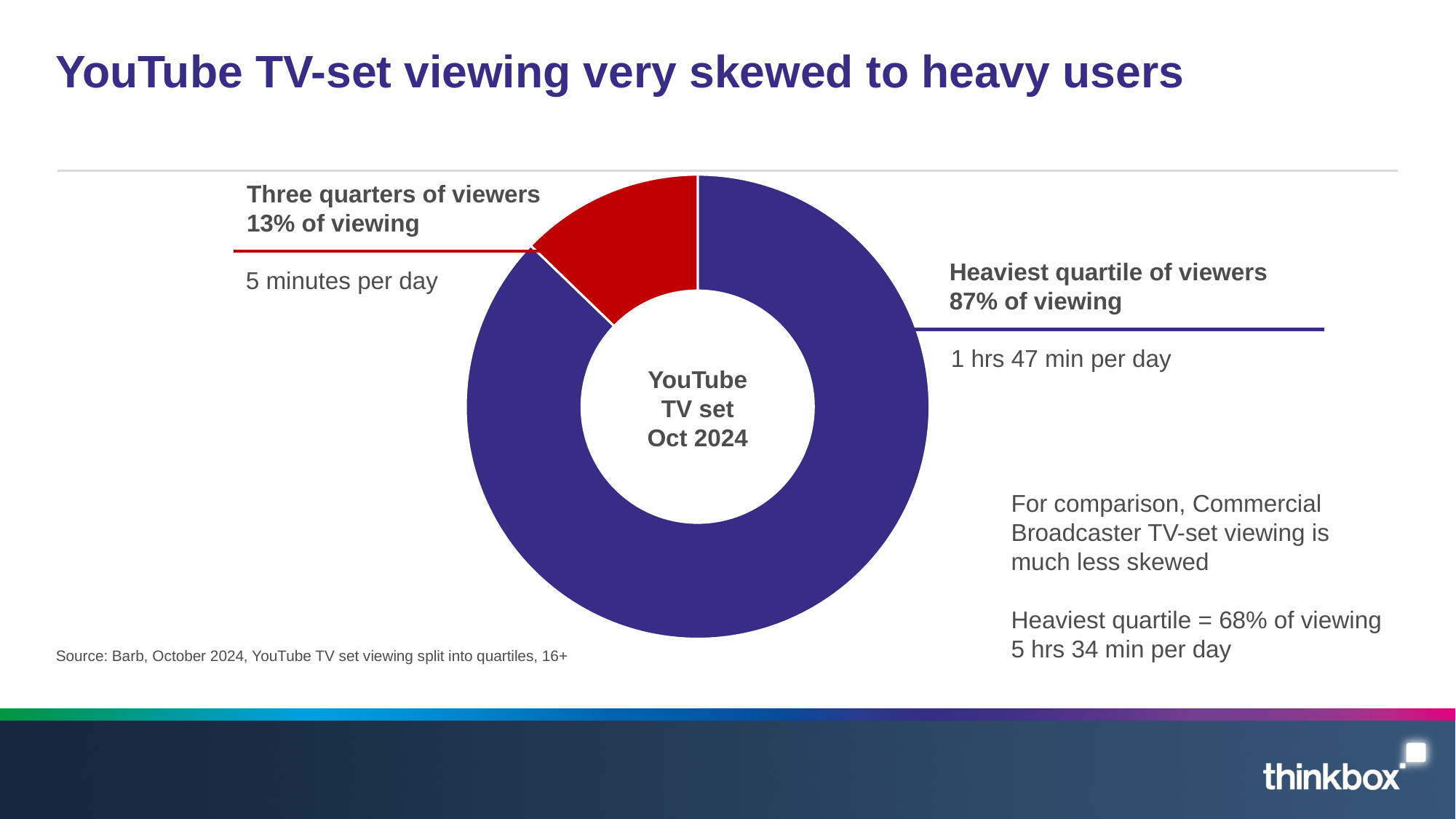
How many segments does the donut chart have? 2 Is the heaviest quartile's share of YouTube TV-set viewing greater or less than 50%? greater What colour is the segment representing the heaviest quartile of viewers? Purple What share of YouTube TV-set viewing comes from the heaviest quartile of viewers? 87% What is the difference in percentage points between the heaviest quartile's share of viewing and the three quarters of viewers' share? 74 percentage points What text is shown in the centre of the donut chart? YouTube TV set Oct 2024 How many minutes per day do the three quarters of viewers in the red segment watch YouTube on a TV set? 5 minutes per day Which segment of the donut chart is the smallest? Three quarters of viewers (13% of viewing) How much time per day does the heaviest quartile of viewers spend watching YouTube on a TV set? 1 hrs 47 min per day What share of YouTube TV-set viewing comes from the three quarters of viewers shown in red? 13% What kind of chart is shown on the slide? Donut (pie) chart Which segment of the donut chart is larger: the heaviest quartile of viewers or the three quarters of viewers? Heaviest quartile of viewers